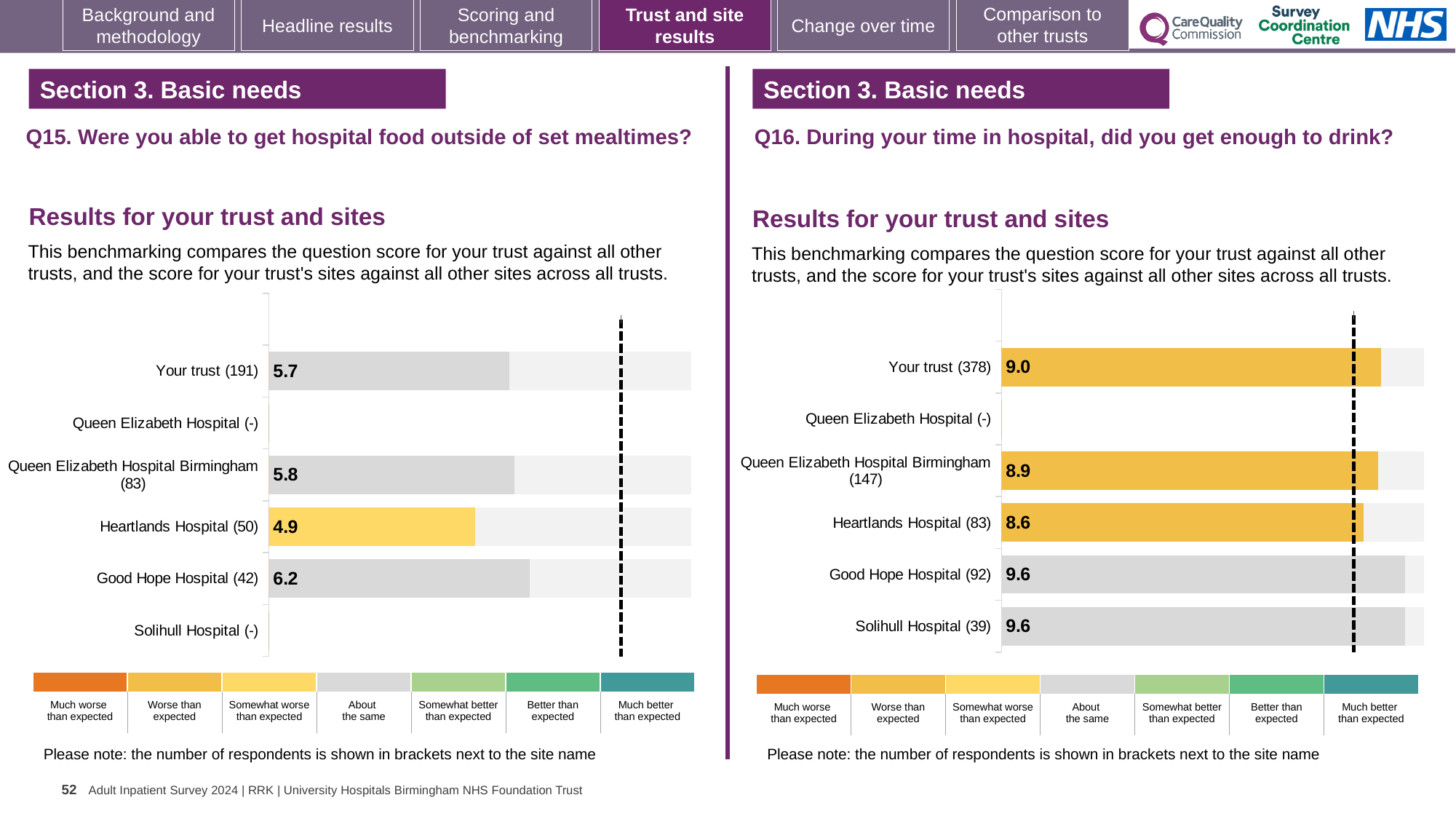
In the Q15 chart on the left, what is the score for Heartlands Hospital? 4.9 In the Q16 chart on the right, what is the score for Queen Elizabeth Hospital Birmingham? 8.9 In the Q16 chart on the right, which is larger: the score for Good Hope Hospital or the score for Heartlands Hospital? Good Hope Hospital In the Q16 chart on the right, what is the difference between the scores for Solihull Hospital and Your trust? 0.6 In the Q15 chart on the left, which site has the lowest score? Heartlands Hospital In the Q15 chart on the left, what is the difference between the scores for Good Hope Hospital and Heartlands Hospital? 1.3 In the Q15 chart on the left, what is the score for Your trust? 5.7 In the Q15 chart on the left, how many rows (sites including Your trust) are listed on the axis? 6 What kind of chart is used for the Q15 results on the left? Bar chart In the Q15 chart on the left, which site has the highest score? Good Hope Hospital In the Q16 chart on the right, which site has the lowest score? Heartlands Hospital In the Q16 chart on the right, what is the score for Your trust? 9.0